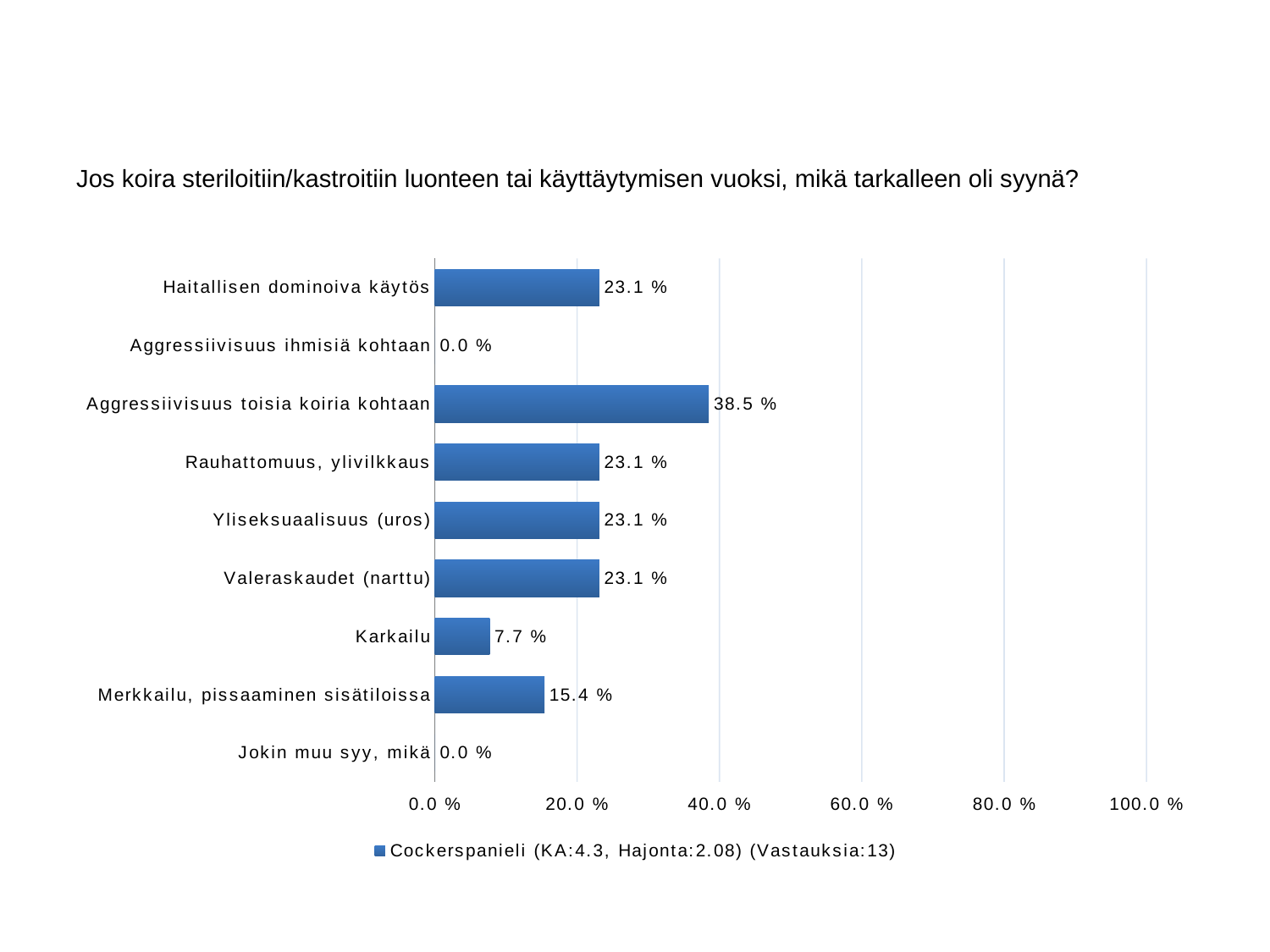
What is the difference between the values for "Aggressiivisuus toisia koiria kohtaan" and "Haitallisen dominoiva käytös"? 15.4 % Which category has the highest value? Aggressiivisuus toisia koiria kohtaan What is the difference between the values for "Merkkailu, pissaaminen sisätiloissa" and "Karkailu"? 7.7 % What is the value for "Aggressiivisuus ihmisiä kohtaan"? 0.0 % Is the value for "Aggressiivisuus toisia koiria kohtaan" greater or less than 40.0 %? less What kind of chart is shown on the slide? bar chart What is the value for "Merkkailu, pissaaminen sisätiloissa"? 15.4 % What is the value for "Aggressiivisuus toisia koiria kohtaan"? 38.5 % What is the value for "Karkailu"? 7.7 % Which is larger, the value for "Karkailu" or the value for "Valeraskaudet (narttu)"? Valeraskaudet (narttu) How many categories are shown on the chart? 9 What is the legend entry for the series shown on the chart? Cockerspanieli (KA:4.3, Hajonta:2.08) (Vastauksia:13)